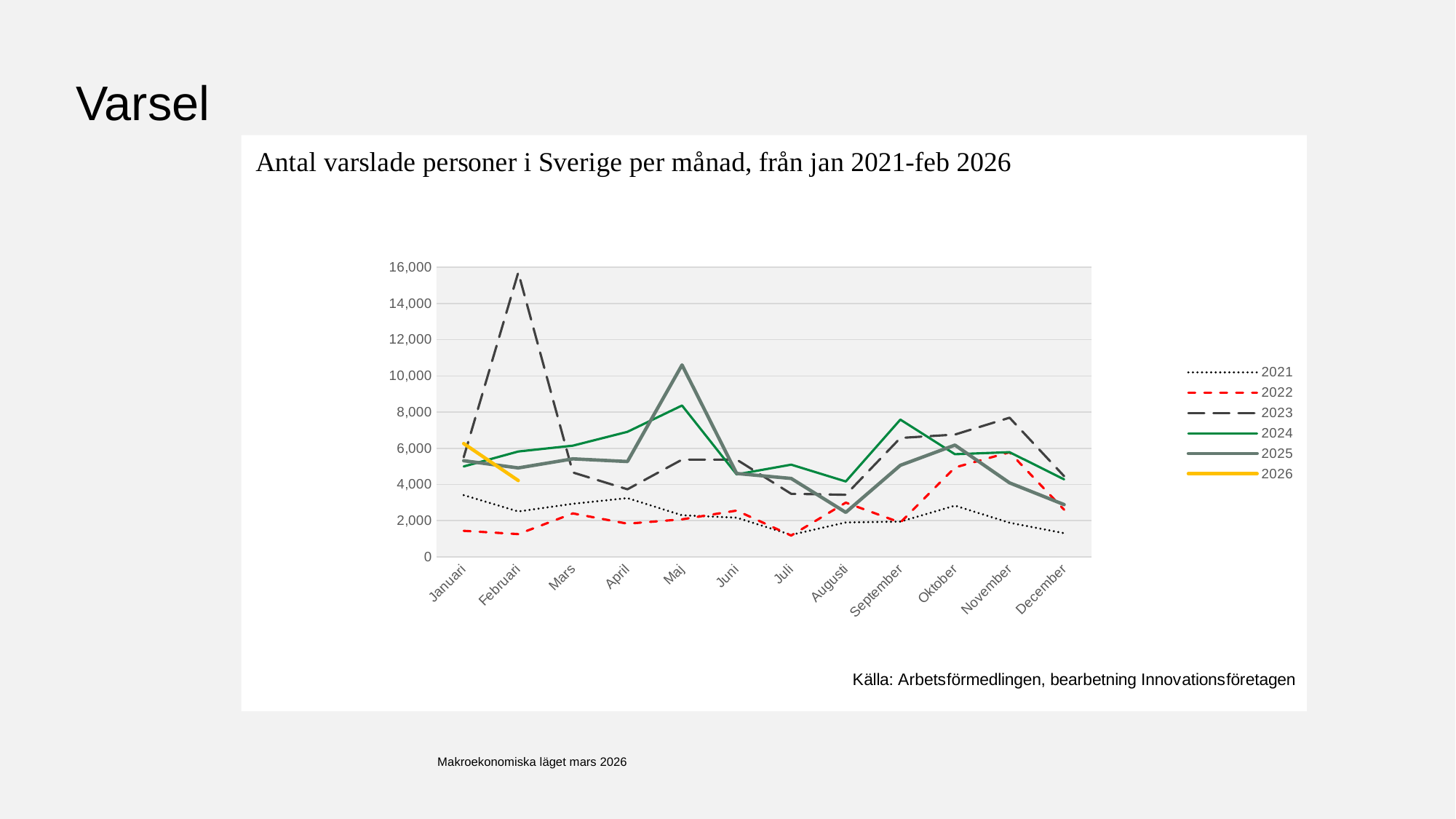
What kind of chart is shown on the slide? line chart In which month does the 2025 series reach its highest value? Maj Is the value for 2023 in Februari greater or less than 14,000? greater Does the 2026 series rise or fall from Januari to Februari? fall Which is larger in Maj, the value for 2024 or the value for 2025? 2025 How many series does the legend list? 6 How many months are shown along the x axis? 12 Is the value for 2022 in Januari greater or less than 2,000? less Is the value for 2026 in Februari greater or less than 6,000? less In which month does the 2023 series reach its highest value? Februari What is the title of the chart? Antal varslade personer i Sverige per månad, från jan 2021-feb 2026